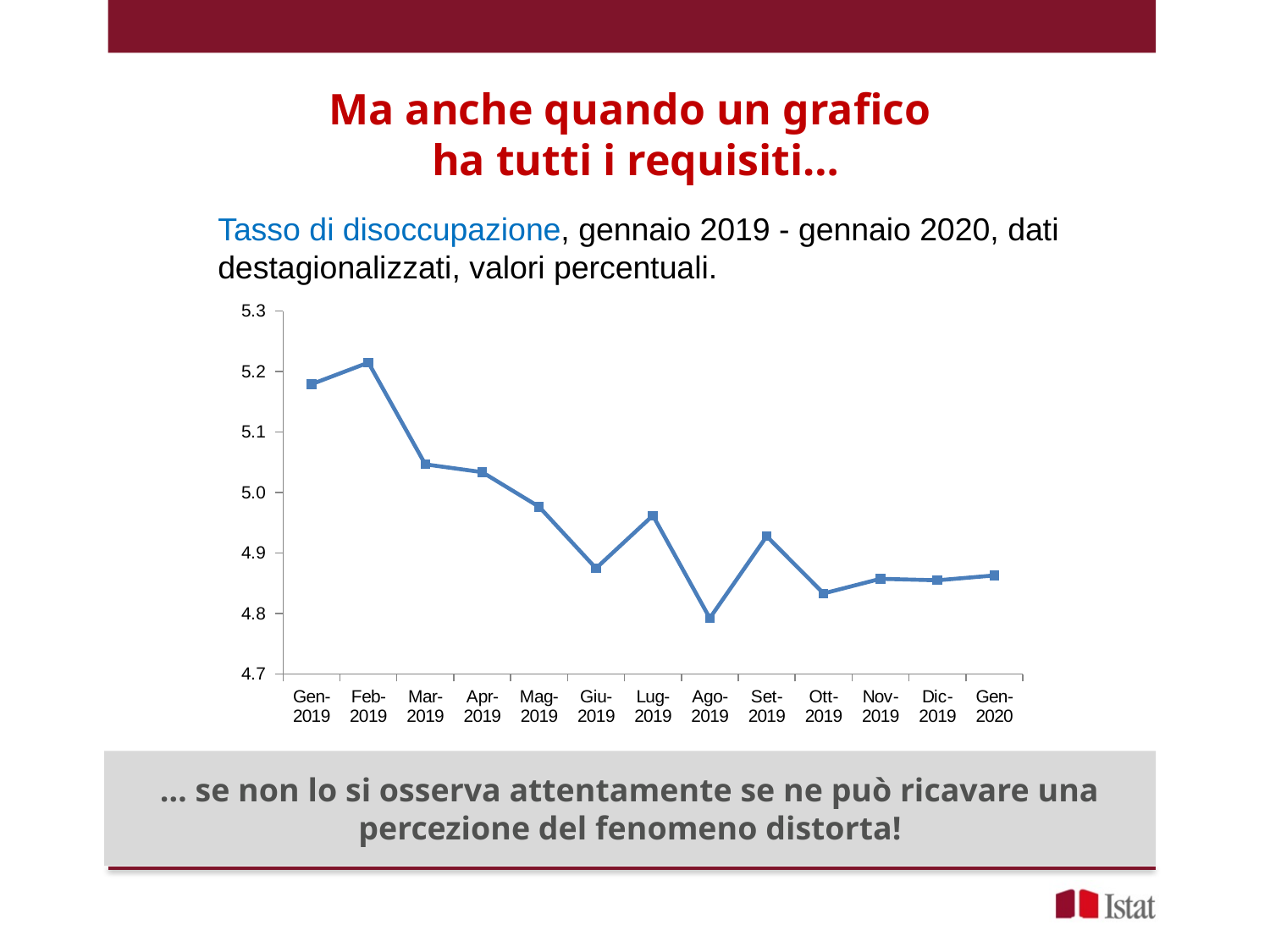
Which is larger, the value for Gen-2019 or the value for Gen-2020? Gen-2019 Is the value for Gen-2019 greater or less than 5.1? greater What kind of chart is shown on the slide? Line chart Is the value for Mar-2019 greater or less than 5.0? greater Which month has the highest unemployment rate on the chart? Feb-2019 Which is larger, the value for Lug-2019 or the value for Giu-2019? Lug-2019 What is the lowest value shown on the vertical axis of the chart? 4.7 Is the value for Ago-2019 greater or less than 4.9? less Which month has the lowest unemployment rate on the chart? Ago-2019 How many monthly data points are plotted on the chart? 13 Overall, does the unemployment rate rise or fall from Gen-2019 to Gen-2020? Fall